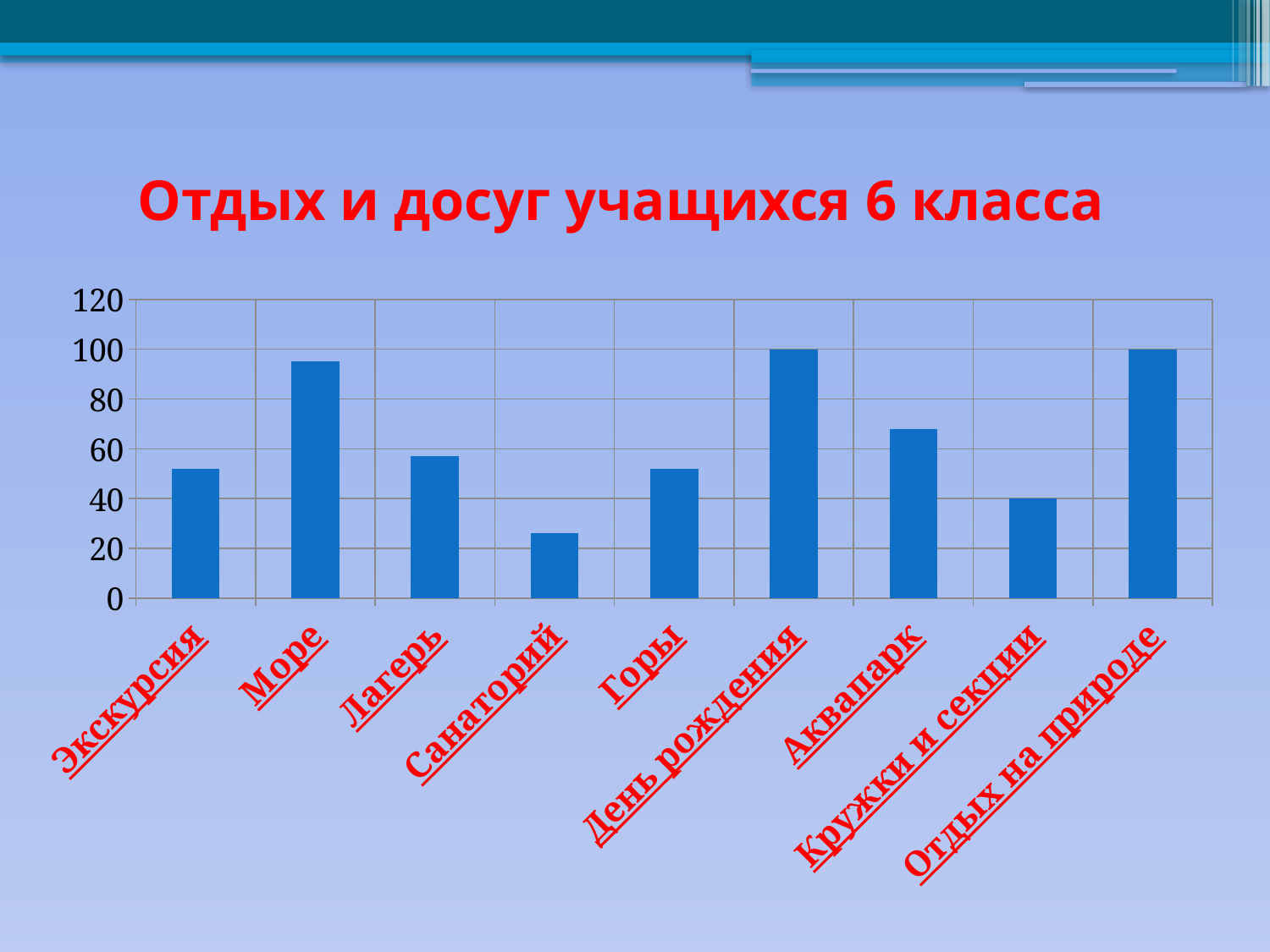
How many categories are shown on the x axis? 9 Is the value for Аквапарк greater or less than 60? greater What is the value for Отдых на природе? 100 What is the value for День рождения? 100 Which is larger, the value for Экскурсия or the value for Санаторий? Экскурсия Is the value for Море greater or less than 80? greater What is the value for Кружки и секции? 40 Which category has the lowest value? Санаторий What kind of chart is shown on the slide? bar chart Is the value for Санаторий greater or less than 40? less Which is larger, the value for Море or the value for Лагерь? Море What is the title of the chart? Отдых и досуг учащихся 6 класса